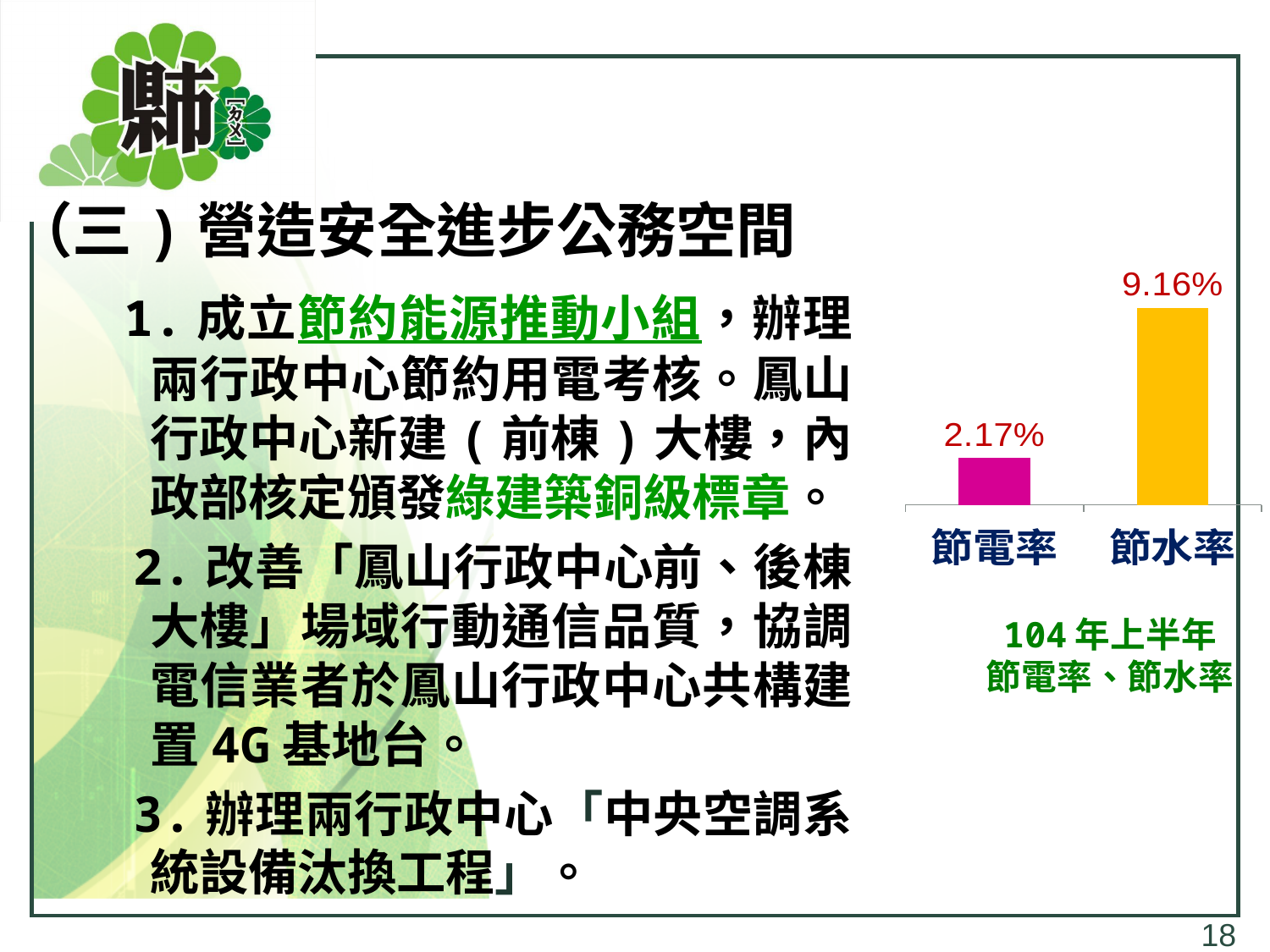
What kind of chart is shown on the slide? bar chart Which category has the highest value in the chart? 節水率 What is the caption printed below the chart? 104年上半年 節電率、節水率 How many categories are shown in the chart? 2 What is the value for 節電率 in the chart? 2.17% What is the value for 節水率 in the chart? 9.16% What is the difference between the values for 節水率 and 節電率? 6.99% What colour is the bar for 節水率? yellow Which is larger, the value for 節電率 or the value for 節水率? 節水率 Which category has the lowest value in the chart? 節電率